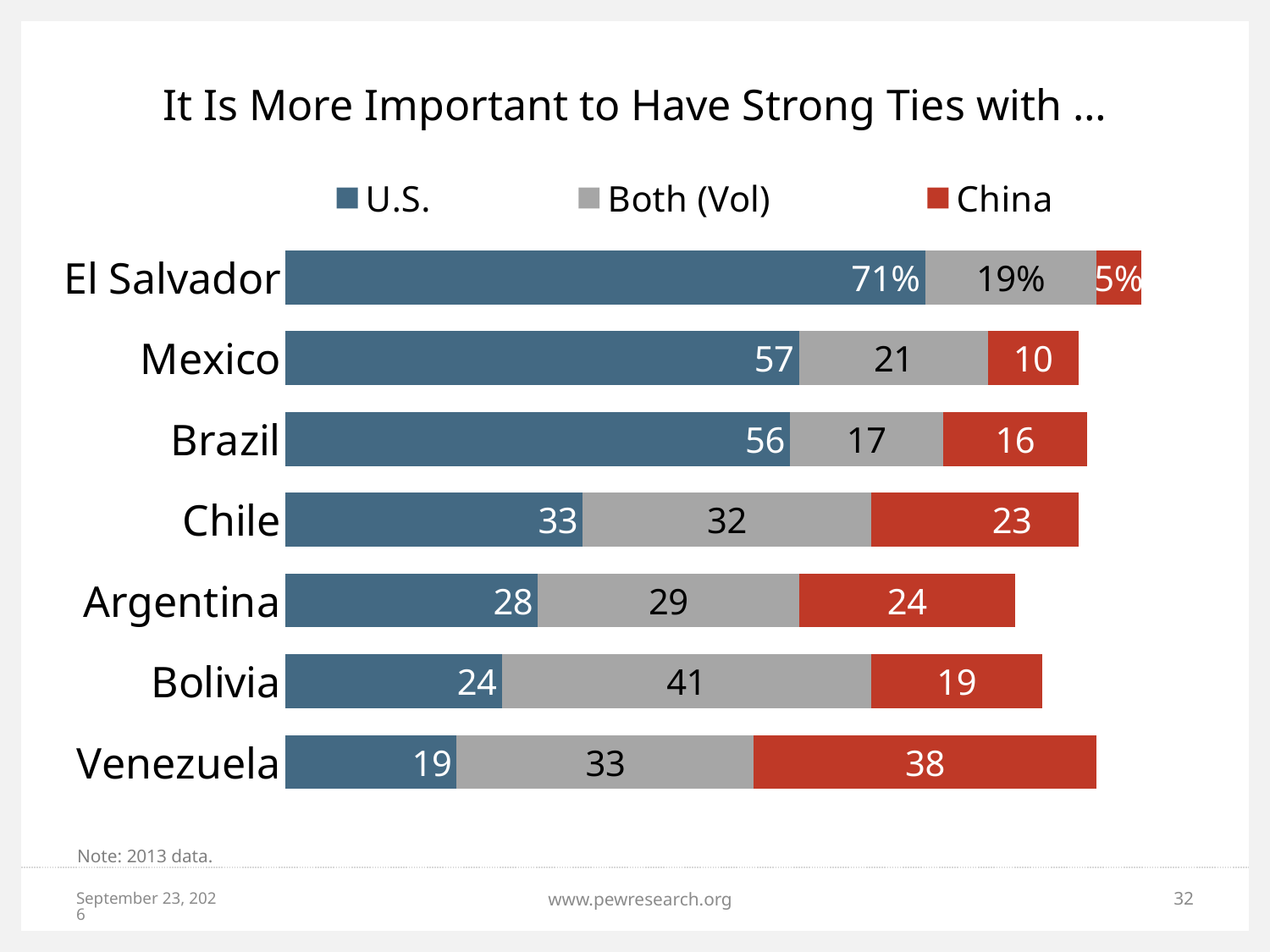
What kind of chart is shown on the slide? Stacked bar chart How many series does the legend list? 3 What is the difference between the U.S. value and the China value for Mexico? 47 What is the Both (Vol) value for Bolivia? 41 Is the China value larger for Chile or for Brazil? Chile What is the total of the three segments for Venezuela? 90 Which country has the highest U.S. value? El Salvador Which country has the lowest U.S. value? Venezuela What is the China value for Venezuela? 38 Which country has the highest China value? Venezuela What percentage of respondents in El Salvador say it is more important to have strong ties with the U.S.? 71% How many countries are shown in the chart? 7